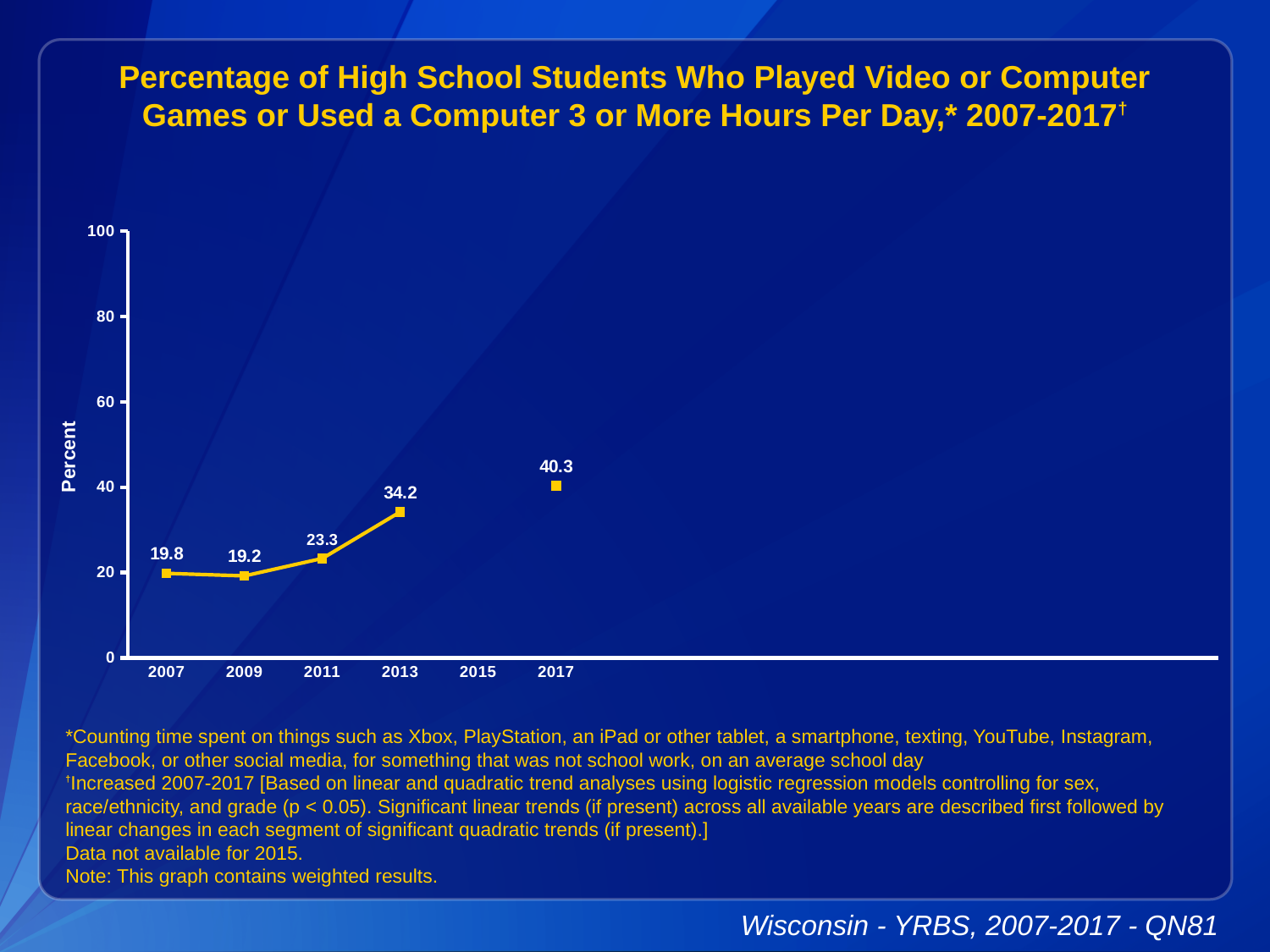
What is the difference between the values for 2017 and 2007? 20.5 Is the value for 2017 greater or less than 40? greater How many years have data points plotted on the chart? 5 Which year has the lowest value? 2009 What is the value for 2007? 19.8 Which year has the highest value? 2017 Which is larger, the value for 2011 or the value for 2009? 2011 What kind of chart is shown on the slide? line chart What is the difference between the values for 2013 and 2011? 10.9 What is the value for 2017? 40.3 What is the label of the y axis? Percent What is the value for 2013? 34.2